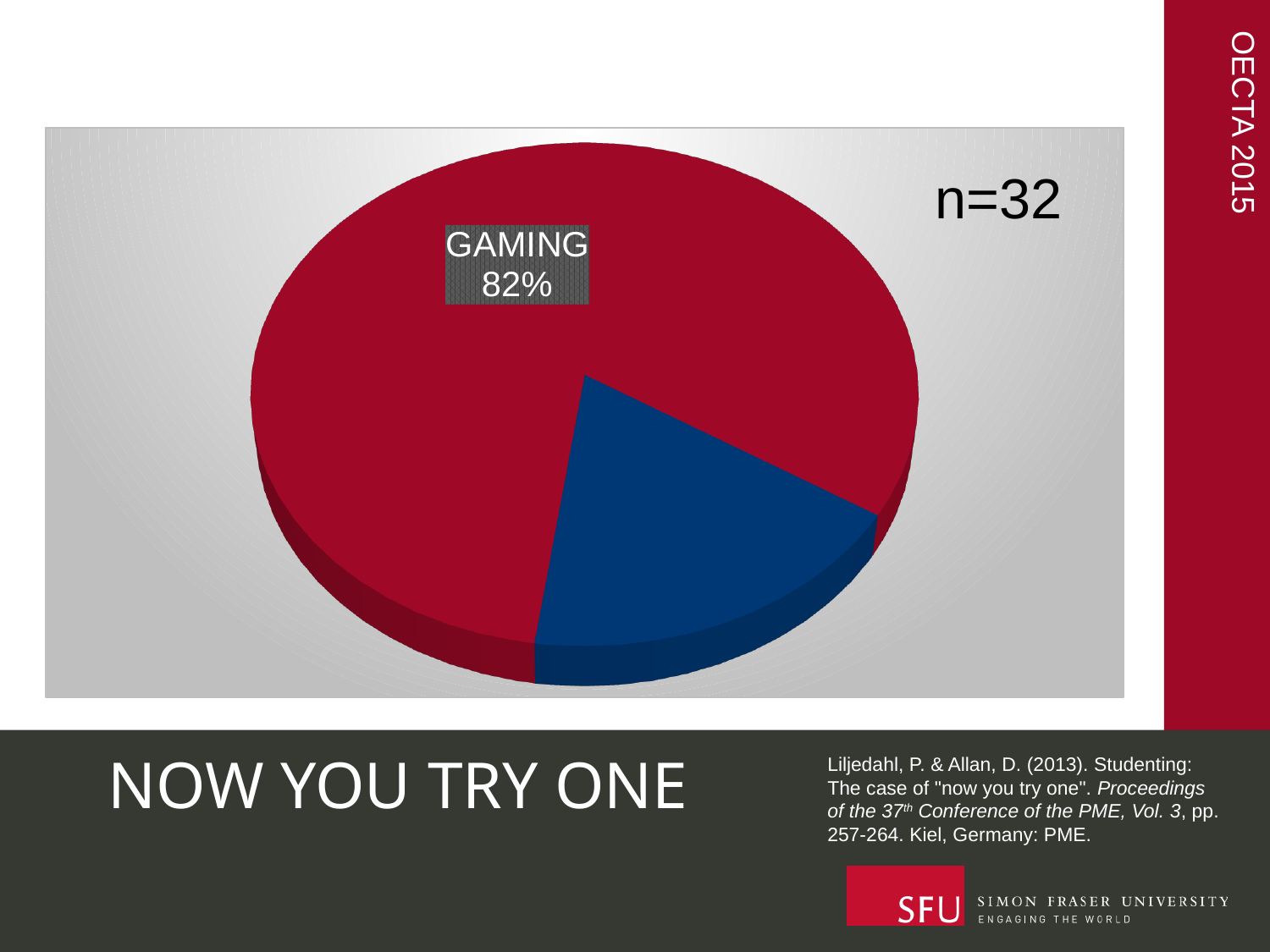
Which is larger: the GAMING slice or the blue slice? GAMING Is the GAMING slice greater or less than 50% of the pie? greater What share of the pie does the GAMING slice represent? 82% What sample size (n) is shown next to the pie chart? n=32 How many slices does the pie chart have? 2 What colour is the GAMING slice of the pie chart? red Which slice of the pie chart is the largest? GAMING What kind of chart is shown on the slide? pie chart